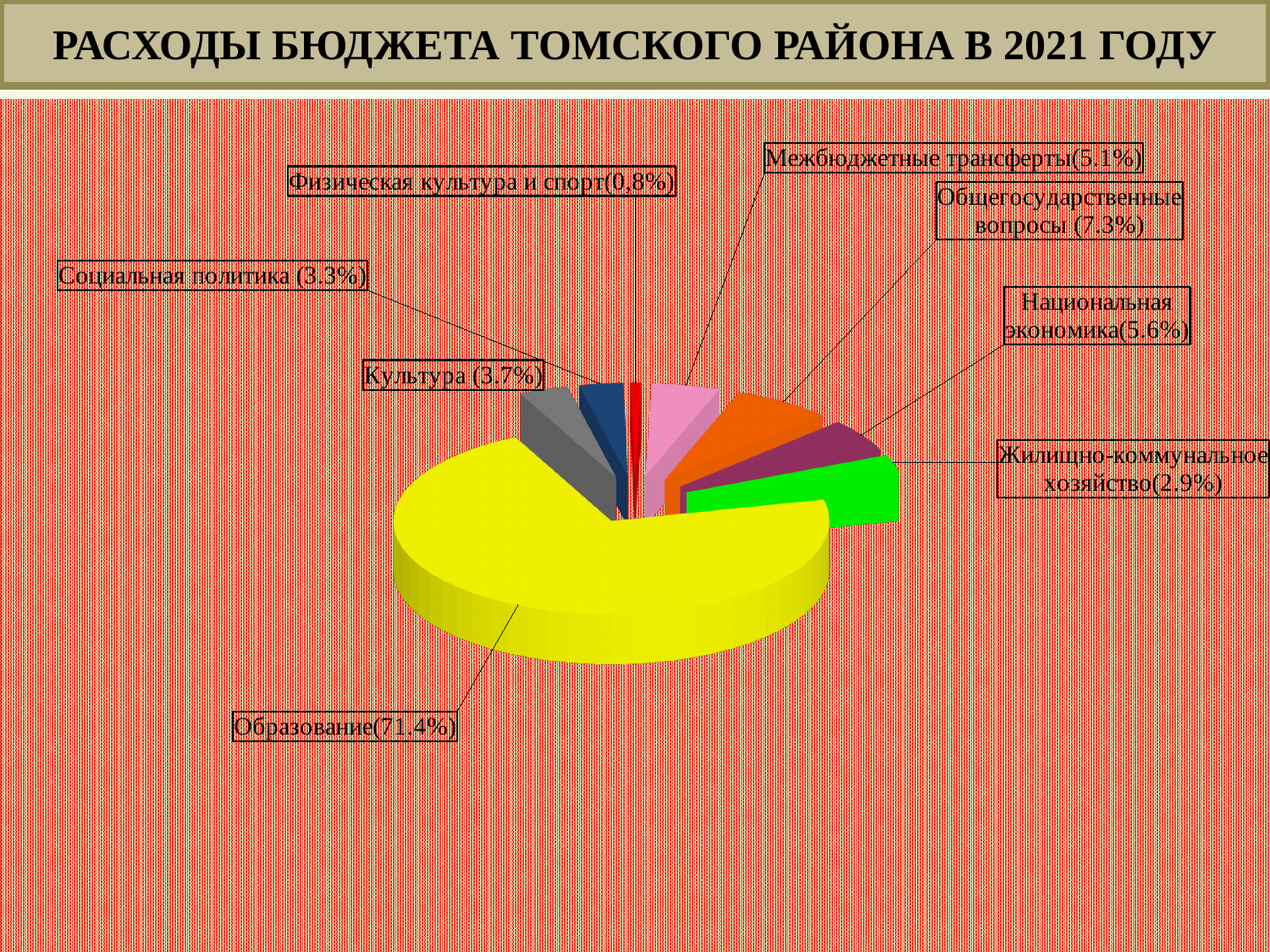
What share is shown for Национальная экономика? 5.6% What share is shown for Жилищно-коммунальное хозяйство? 2.9% Which category has the largest share of the pie? Образование What share is shown for Общегосударственные вопросы? 7.3% What kind of chart is shown on the slide? Pie chart How many categories are shown in the pie chart? 8 What share is shown for Физическая культура и спорт? 0,8% What share of the budget expenditure goes to Образование? 71.4% Which is larger: the share for Межбюджетные трансферты or the share for Культура? Межбюджетные трансферты What is the difference between the shares for Общегосударственные вопросы and Социальная политика? 4.0% Which category has the smallest share of the pie? Физическая культура и спорт What is the title of the slide? РАСХОДЫ БЮДЖЕТА ТОМСКОГО РАЙОНА В 2021 ГОДУ